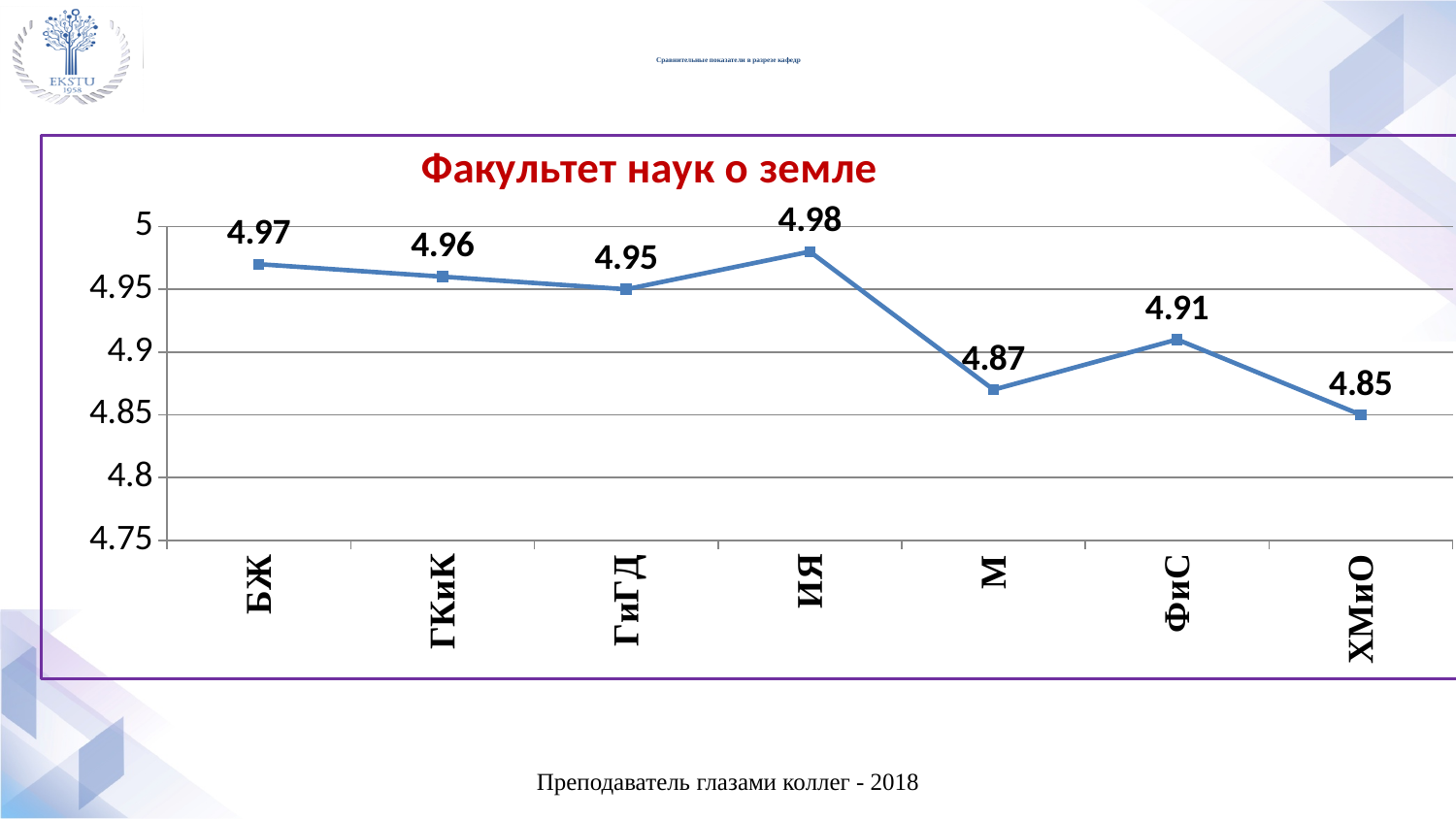
What is the title of the chart? Факультет наук о земле What is the value for ХМиО? 4.85 What is the difference between the values for БЖ and М? 0.10 What is the value for ИЯ? 4.98 Which category has the highest value? ИЯ What is the value for ФиС? 4.91 Which is larger, the value for ГКиК or the value for ФиС? ГКиК Which category has the lowest value? ХМиО How many categories are plotted on the chart? 7 Do the values rise or fall from ИЯ to М? fall Is the value for М greater or less than 4.9? less What kind of chart is shown on the slide? line chart